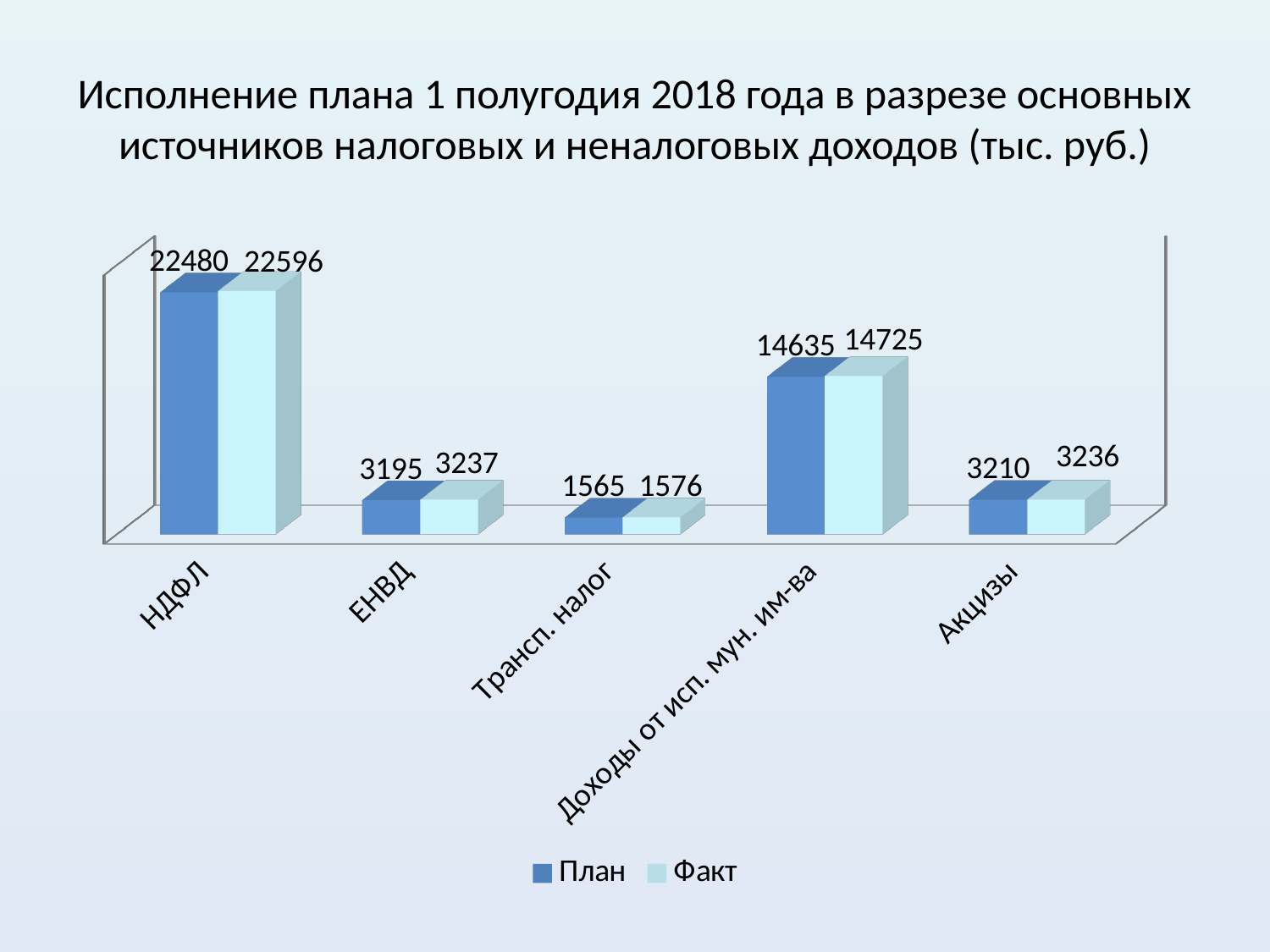
What is the difference between the Факт and План values for НДФЛ? 116 What is the План value for НДФЛ? 22480 Which category has the highest Факт value? НДФЛ Which category has the lowest План value? Трансп. налог What is the План value for Акцизы? 3210 Which is larger for Доходы от исп. мун. им-ва: the План value or the Факт value? Факт How many categories are shown on the x axis? 5 What kind of chart is shown on the slide? Bar chart What is the difference between the Факт and План values for ЕНВД? 42 What is the Факт value for Доходы от исп. мун. им-ва? 14725 How many series does the legend list? 2 What is the Факт value for Трансп. налог? 1576